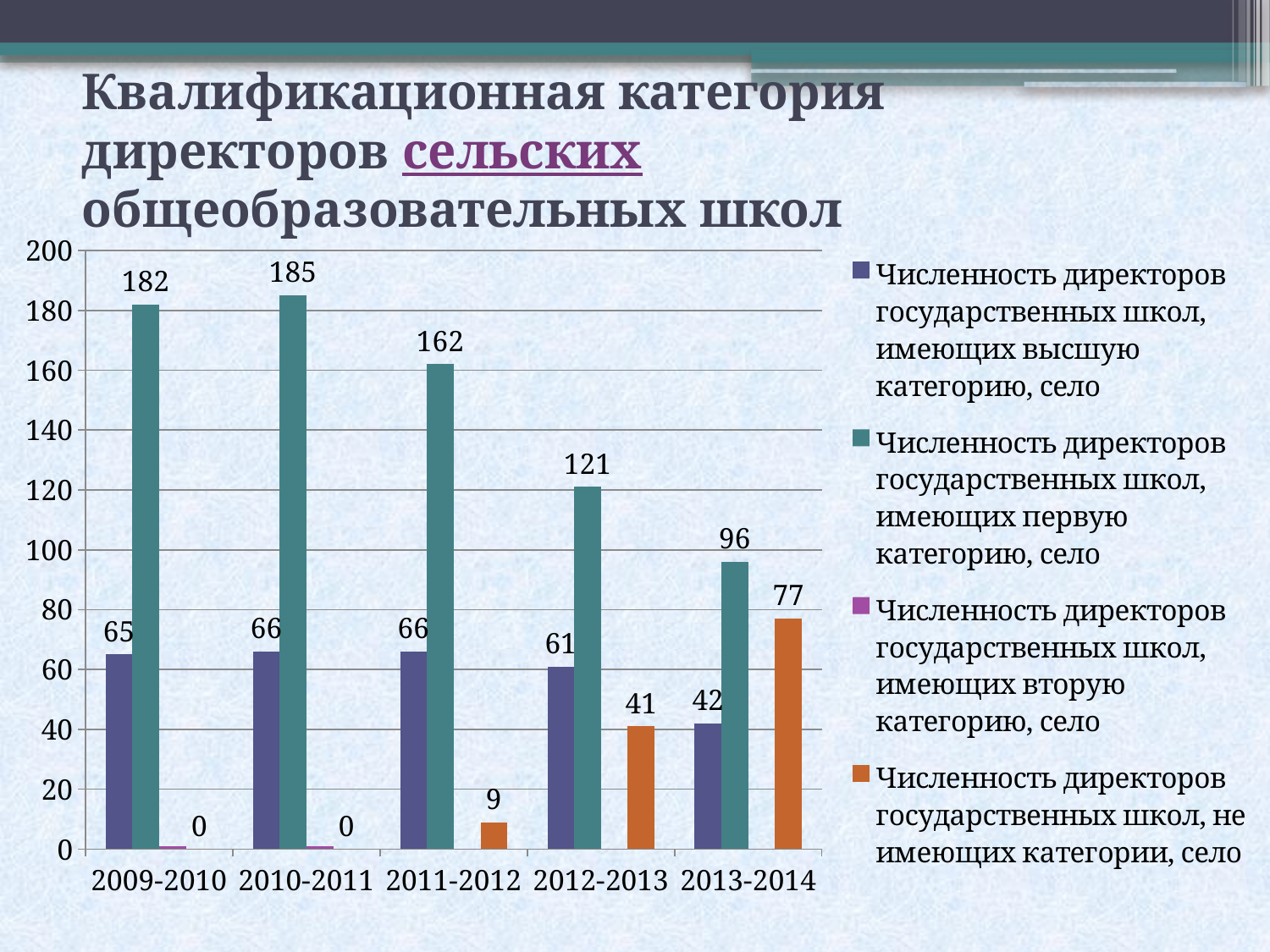
Does the number of directors with the first category rise or fall from 2010-2011 to 2013-2014? fall What is the number of directors with the highest category (высшую категорию) in 2013-2014? 42 In which year is the number of directors with the first category (первую категорию) the highest? 2010-2011 In which year is the number of directors with the highest category (высшую категорию) the lowest? 2013-2014 What is the number of directors with the first category (первую категорию) in 2010-2011? 185 What is the number of directors without a category (не имеющих категории) in 2011-2012? 9 How many year categories are shown on the x axis? 5 How many series does the legend list? 4 What is the difference between the number of directors with the first category in 2009-2010 and in 2013-2014? 86 Which is larger in 2012-2013: the number of directors with the highest category or the number without a category? highest category (61) What kind of chart is shown on the slide? bar chart